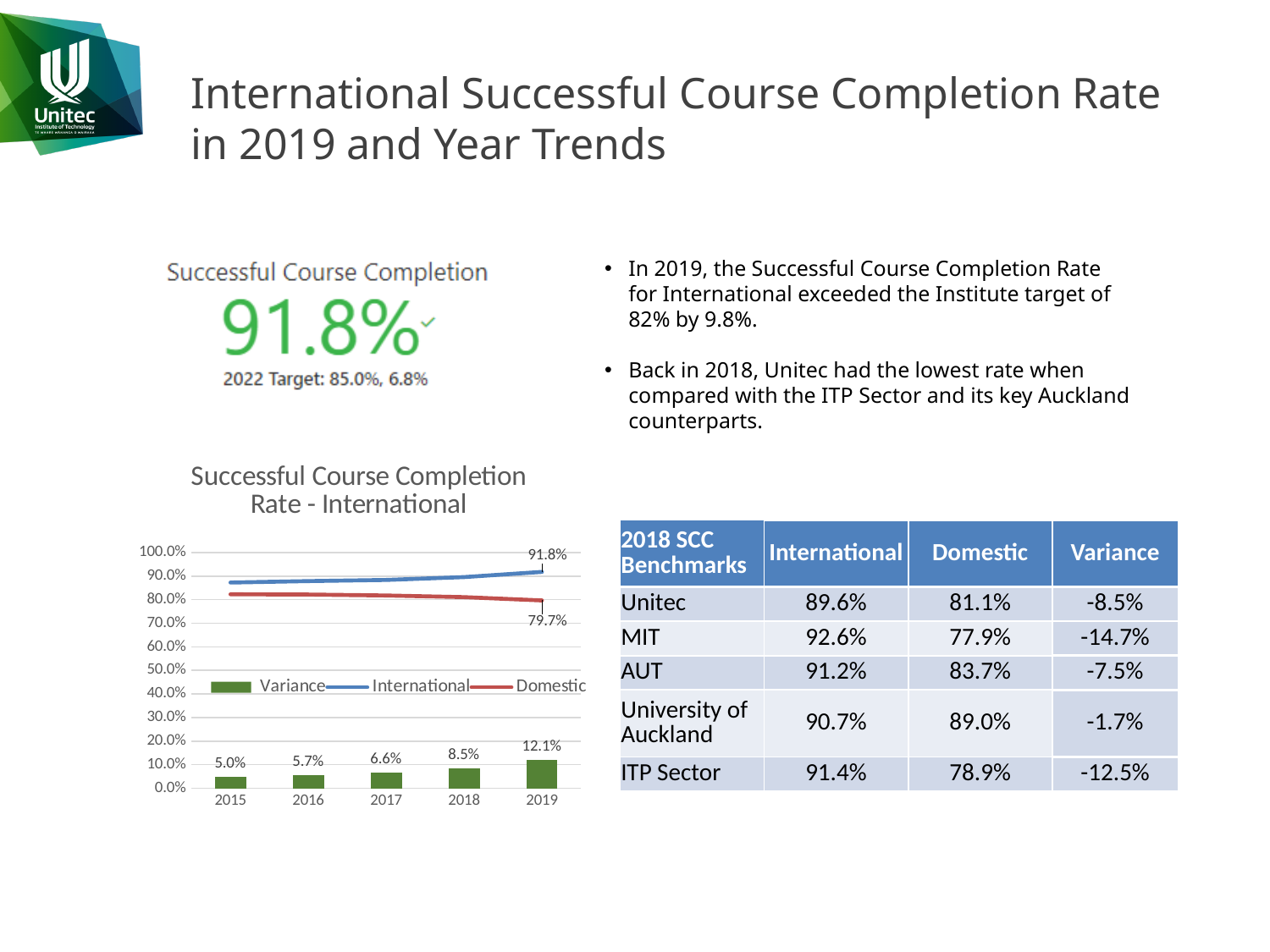
What is the Variance value for 2015 in the chart? 5.0% Which year has the highest Variance value in the chart? 2019 Do the Variance values rise or fall from 2015 to 2019? rise What is the difference between the Variance values for 2019 and 2018? 3.6% How many years are shown on the x axis of the chart? 5 What is the Variance value for 2019 in the Successful Course Completion Rate - International chart? 12.1% Is the Variance value for 2017 greater or less than 10.0%? less Which year has the lowest Variance value in the chart? 2015 What is the International rate shown for 2019 in the chart? 91.8% What is the difference between the International and Domestic rates in 2019? 12.1% How many series does the chart legend list? 3 What is the Domestic rate shown for 2019 in the chart? 79.7%